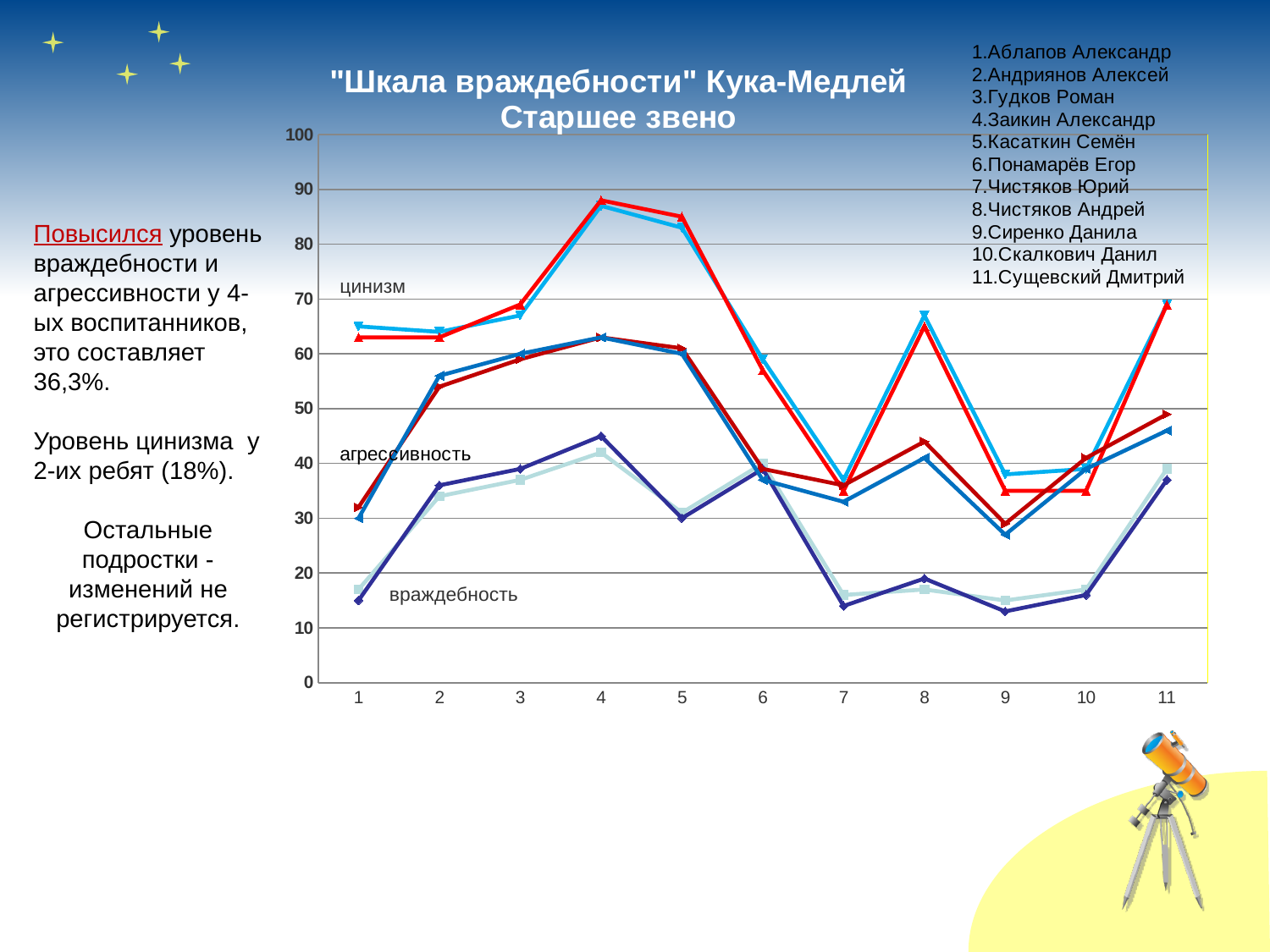
What kind of chart is shown on the slide? line chart At which x-axis point does the цинизм line reach its highest value? 4 Between point 4 and point 7, does the цинизм line rise or fall? fall What is the title of the chart? "Шкала враждебности" Кука-Медлей Старшее звено Is the враждебность value at point 7 greater or less than 20? less At point 4, which is higher: цинизм or враждебность? цинизм Which three scales are labelled on the chart lines? цинизм, агрессивность, враждебность Is the агрессивность value at point 11 greater or less than 40? greater How many points (categories) are shown along the x axis of the chart? 11 Is the агрессивность value at point 1 greater or less than 40? less